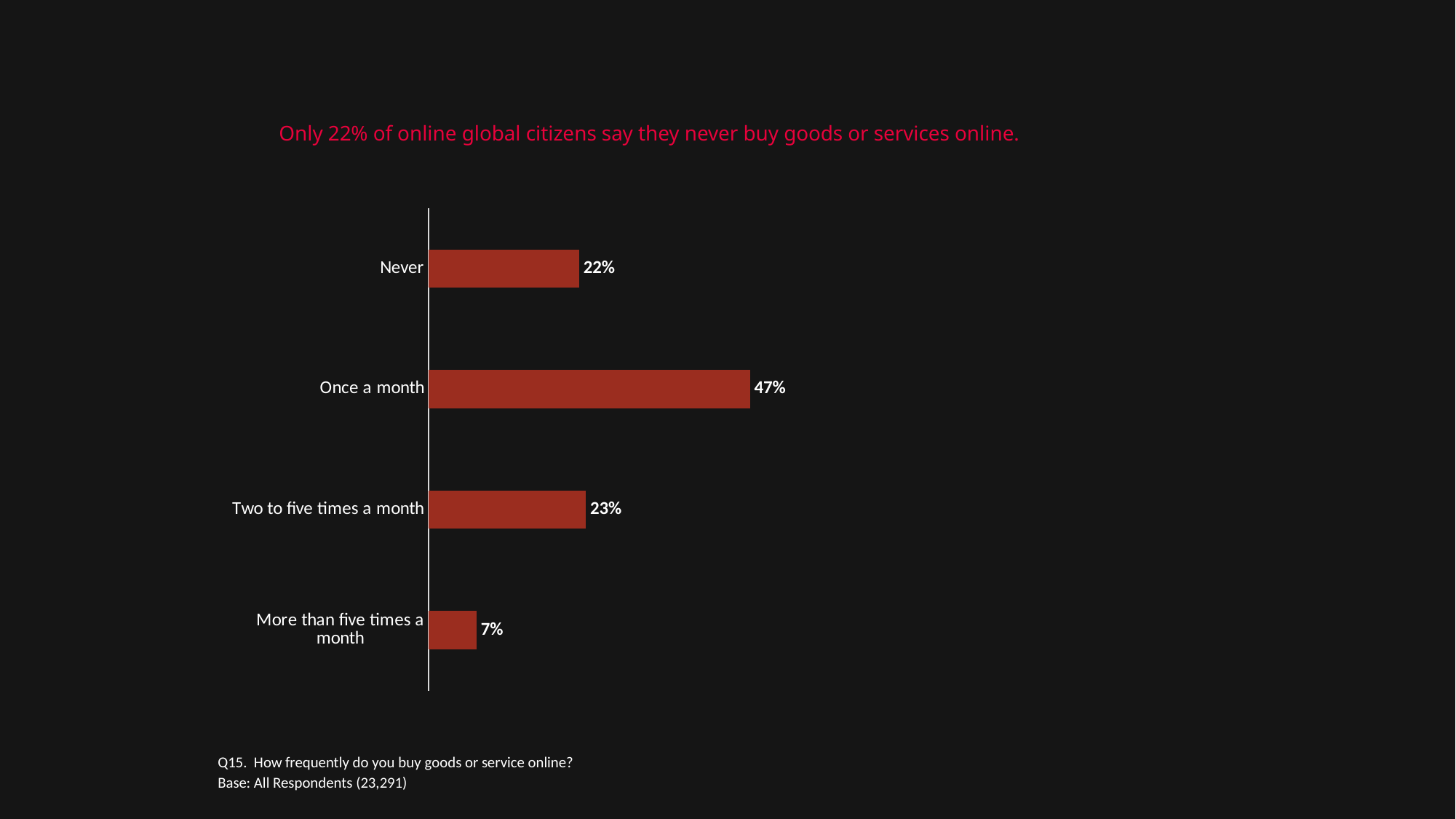
What is the difference between the values for 'Two to five times a month' and 'More than five times a month'? 16% Which is larger, the value for 'Never' or the value for 'Once a month'? Once a month Which category has the highest value? Once a month What is the value for 'Two to five times a month'? 23% What is the value for 'Once a month'? 47% Which category has the lowest value? More than five times a month What is the difference between the values for 'Once a month' and 'Never'? 25% How many categories are shown in the chart? 4 What percentage of respondents say they never buy goods or services online? 22% What kind of chart is shown on the slide? Bar chart What is the value for 'More than five times a month'? 7% What is the base (number of respondents) stated on the slide? 23,291